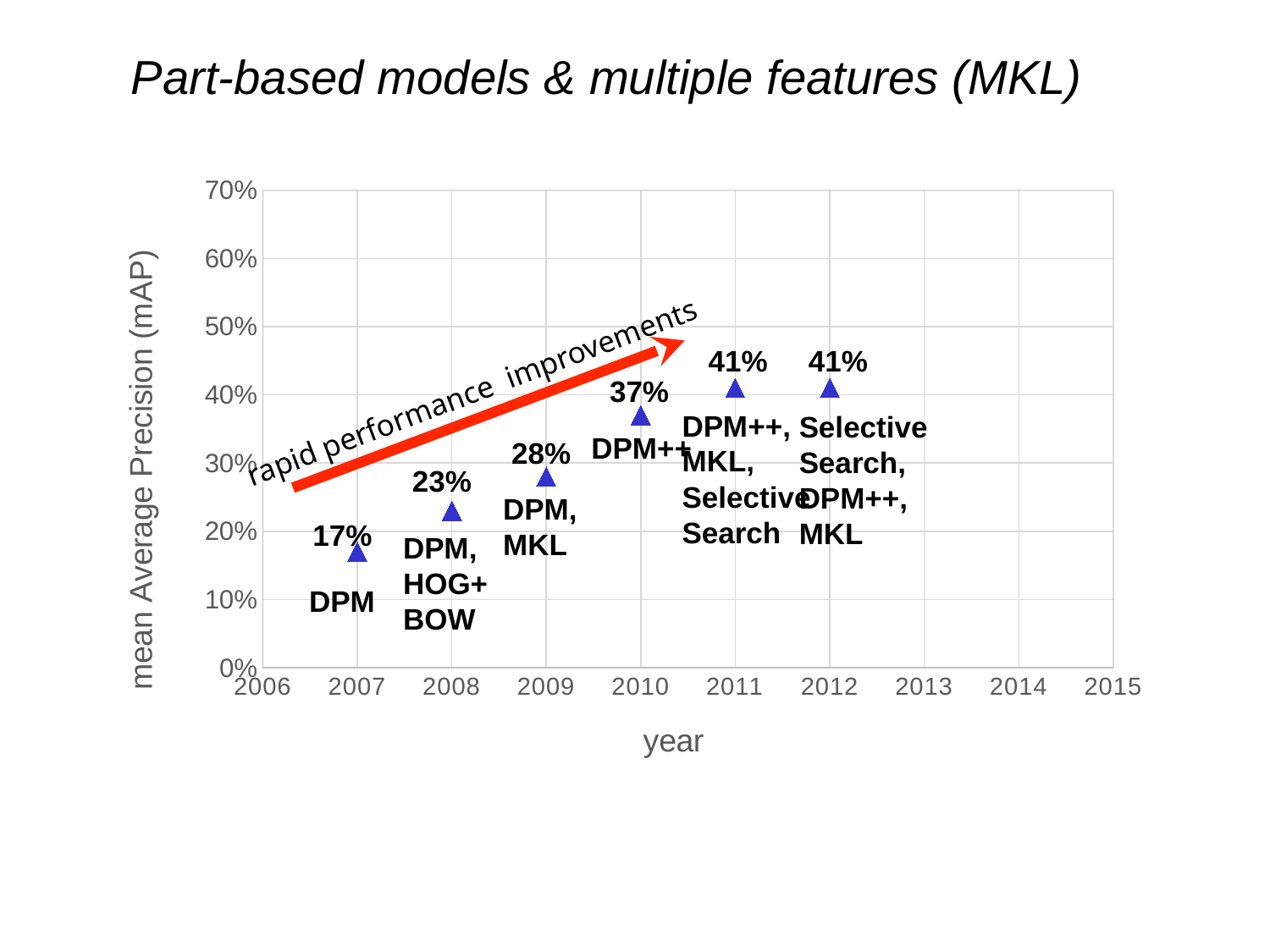
What kind of chart is shown on the slide? scatter chart What is the mAP value plotted for 2010? 37% What is the difference in mAP between 2011 and 2007? 24% What is the difference in mAP between 2010 and 2008? 14% How many data points are plotted on the chart? 6 What is the mean Average Precision (mAP) value plotted for 2007? 17% What is the mAP value plotted for 2012? 41% Which year has the lowest plotted mAP value? 2007 What is the mAP value plotted for 2009? 28% Do the plotted mAP values rise or fall from 2007 to 2012? rise Is the mAP value for 2010 greater or less than 30%? greater Which is larger, the mAP value for 2009 or for 2008? 2009